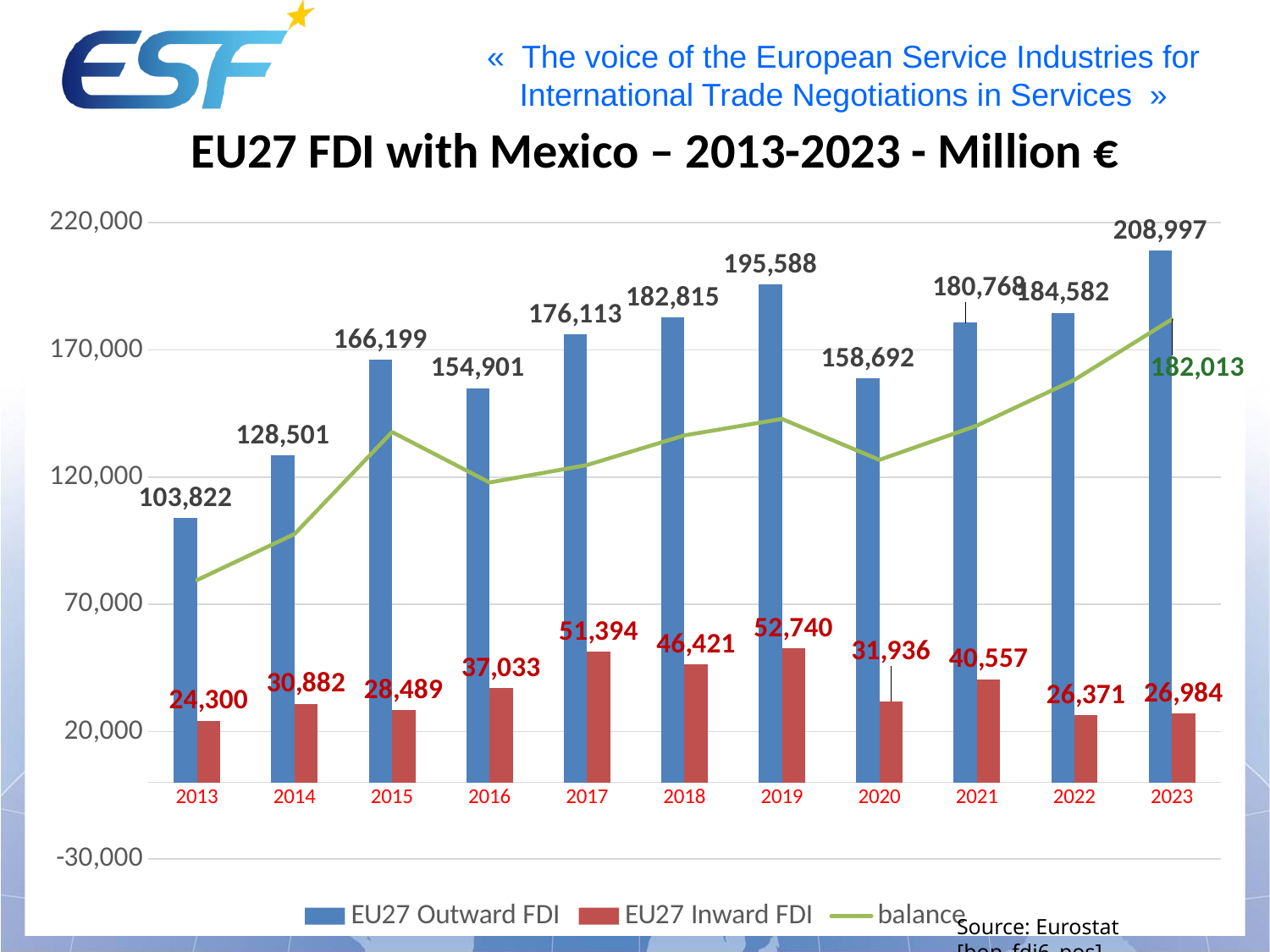
In which year is EU27 Outward FDI highest? 2023 What is the balance value shown for 2023? 182,013 What is the EU27 Outward FDI value for 2019? 195,588 How many years are shown on the x axis? 11 Does EU27 Inward FDI rise or fall from 2019 to 2022? fall How many series does the legend list? 3 What kind of chart is shown on the slide? bar chart with a line What is the difference between EU27 Outward FDI in 2023 and in 2022? 24,415 Which year has the larger EU27 Inward FDI, 2018 or 2019? 2019 In which year is EU27 Inward FDI lowest? 2013 Is the balance value for 2013 greater or less than 120,000? less What is the EU27 Inward FDI value for 2017? 51,394